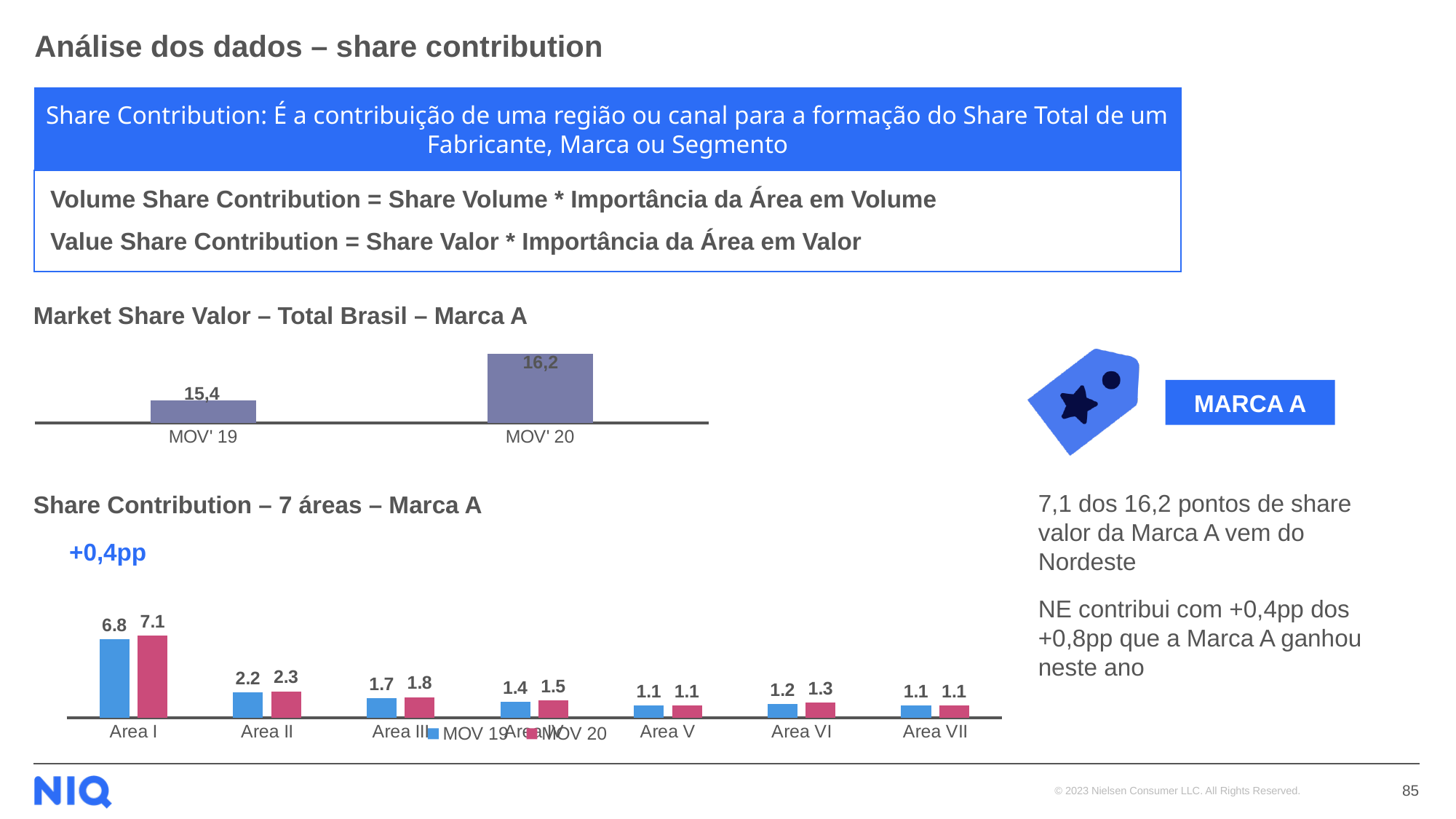
In the 'Share Contribution – 7 áreas – Marca A' chart, what is the MOV 19 value for Area III? 1.7 What type of chart is the 'Share Contribution – 7 áreas – Marca A' chart? bar chart In the 'Share Contribution – 7 áreas – Marca A' chart, what colour are the MOV 20 bars? pink In the 'Share Contribution – 7 áreas – Marca A' chart, which area has the highest MOV 20 value? Area I In the 'Market Share Valor – Total Brasil – Marca A' chart, what is the value for MOV' 19? 15,4 In the 'Market Share Valor – Total Brasil – Marca A' chart, what is the value for MOV' 20? 16,2 In the 'Market Share Valor – Total Brasil – Marca A' chart, does the value rise or fall from MOV' 19 to MOV' 20? rise How many areas are shown in the 'Share Contribution – 7 áreas – Marca A' chart? 7 In the 'Share Contribution – 7 áreas – Marca A' chart, which is larger: the MOV 19 value for Area II or the MOV 19 value for Area VI? Area II How many series does the legend of the 'Share Contribution – 7 áreas – Marca A' chart list? 2 In the 'Share Contribution – 7 áreas – Marca A' chart, what is the MOV 20 value for Area I? 7.1 In the 'Share Contribution – 7 áreas – Marca A' chart, what is the difference between the MOV 20 and MOV 19 values for Area I? 0.3